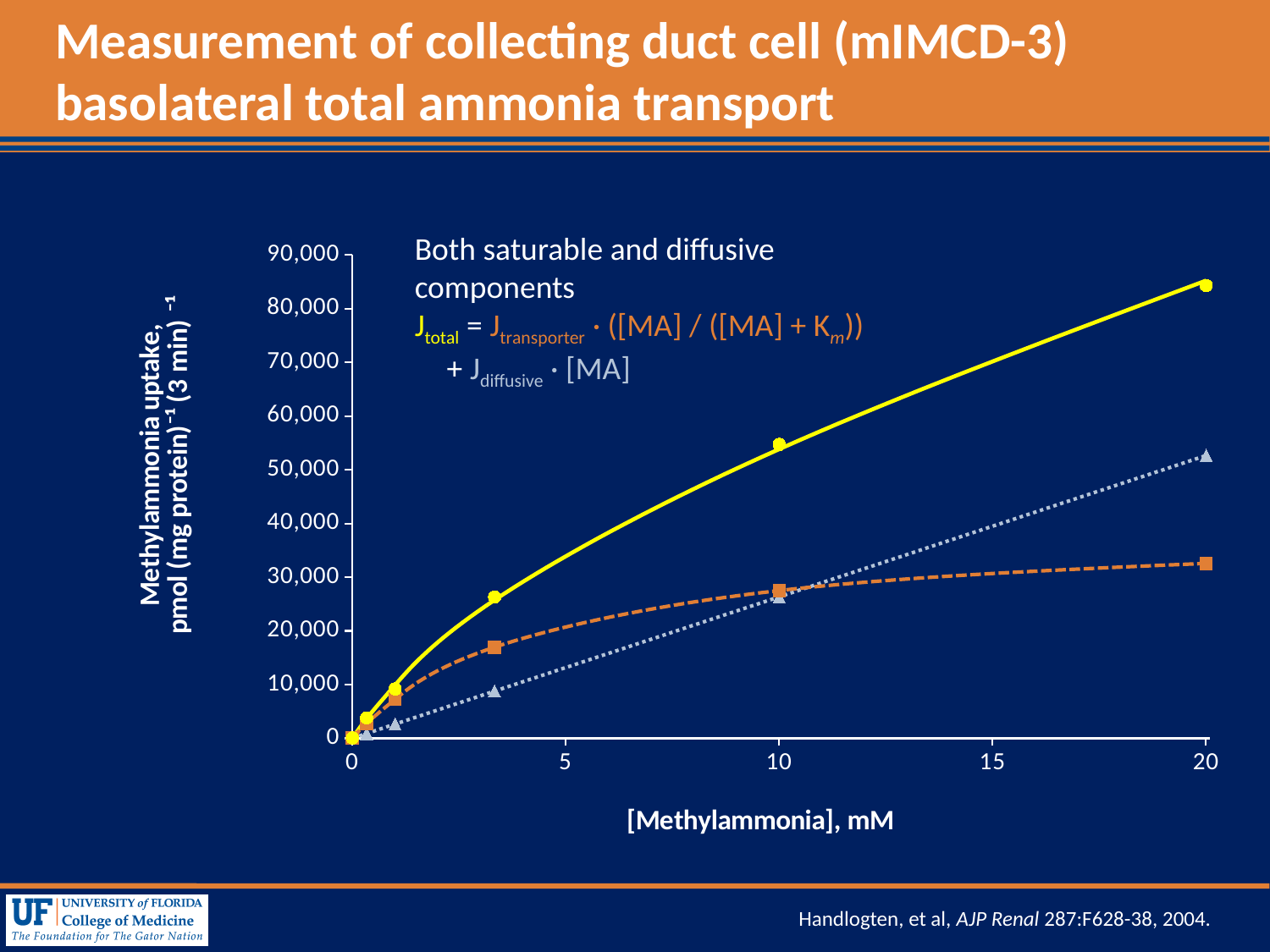
Is the value of the solid yellow line at 20 mM greater or less than 80,000? greater Is the value of the solid yellow line at 10 mM greater or less than 50,000? greater At 20 mM, which is higher: the orange dashed line or the dotted line? the dotted line Which line has the highest value at 20 mM? the solid yellow line What is the x-axis title of the chart? [Methylammonia], mM Is the value of the orange dashed line at 10 mM greater or less than 30,000? less What kind of chart is shown on the slide? line chart How many lines (series) are plotted on the chart? 3 What is the highest value shown on the y-axis of the chart? 90,000 Does the solid yellow line rise or fall as [Methylammonia] increases from 0 to 20 mM? rise Which line has the lowest value at 20 mM? the orange dashed line